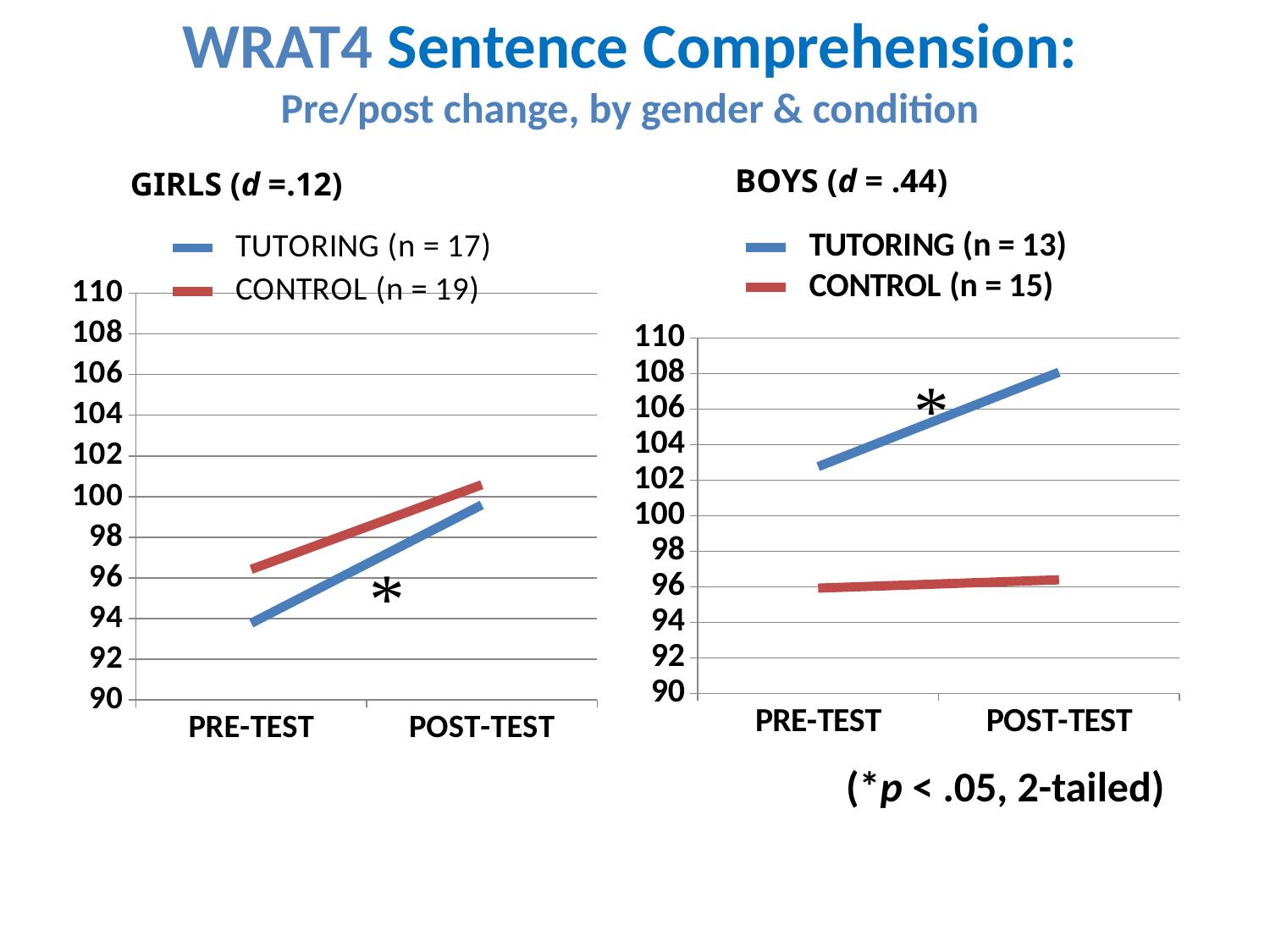
What sample size does the legend of the GIRLS chart give for the CONTROL group? n = 19 How many categories are on the x axis of the GIRLS chart? 2 In the GIRLS chart, which series has the higher value at PRE-TEST, TUTORING or CONTROL? CONTROL What colour is the TUTORING line in the BOYS chart? blue In the BOYS chart, is the TUTORING value at POST-TEST greater or less than 106? greater In the GIRLS chart, is the TUTORING value at PRE-TEST greater or less than 96? less In the BOYS chart, which series has the higher value at POST-TEST, TUTORING or CONTROL? TUTORING In the GIRLS chart, does the CONTROL line rise or fall from PRE-TEST to POST-TEST? rise How many series does the legend of the BOYS chart list? 2 What kind of chart is the GIRLS chart? line chart In the BOYS chart, is the CONTROL value at POST-TEST greater or less than 98? less In the BOYS chart, does the TUTORING line rise or fall from PRE-TEST to POST-TEST? rise